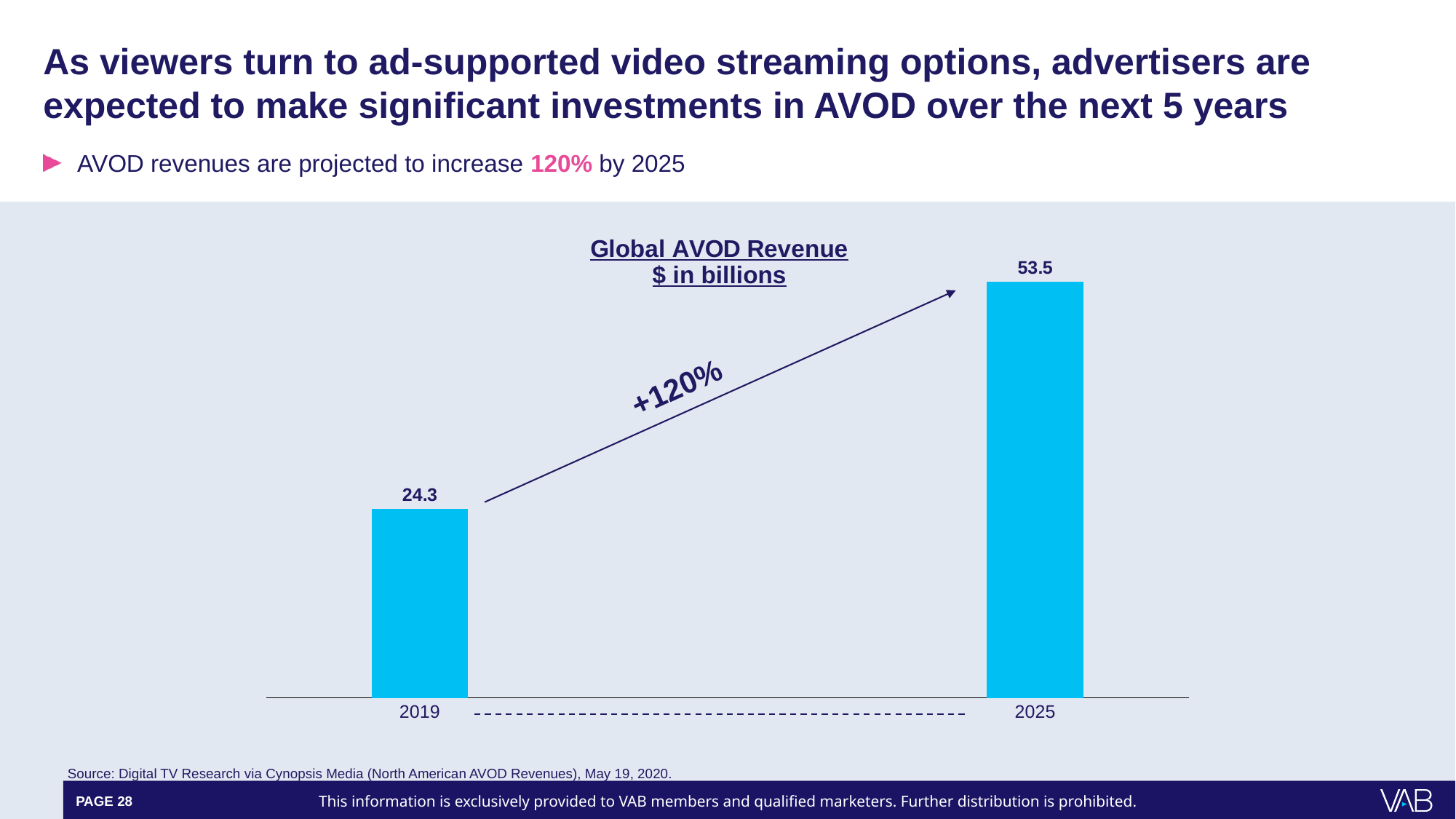
Which year has the higher Global AVOD Revenue? 2025 Does Global AVOD Revenue rise or fall from 2019 to 2025? rise What is the Global AVOD Revenue value for 2019? 24.3 Is the Global AVOD Revenue value for 2025 larger or smaller than the value for 2019? larger What kind of chart is used to show Global AVOD Revenue? bar chart Which year has the lower Global AVOD Revenue? 2019 What is the Global AVOD Revenue value for 2025? 53.5 What percentage increase is labelled on the arrow between the 2019 and 2025 bars? +120% What is the difference between the 2025 and 2019 Global AVOD Revenue values? 29.2 What unit is stated in the chart title for Global AVOD Revenue? $ in billions How many years are shown in the Global AVOD Revenue chart? 2